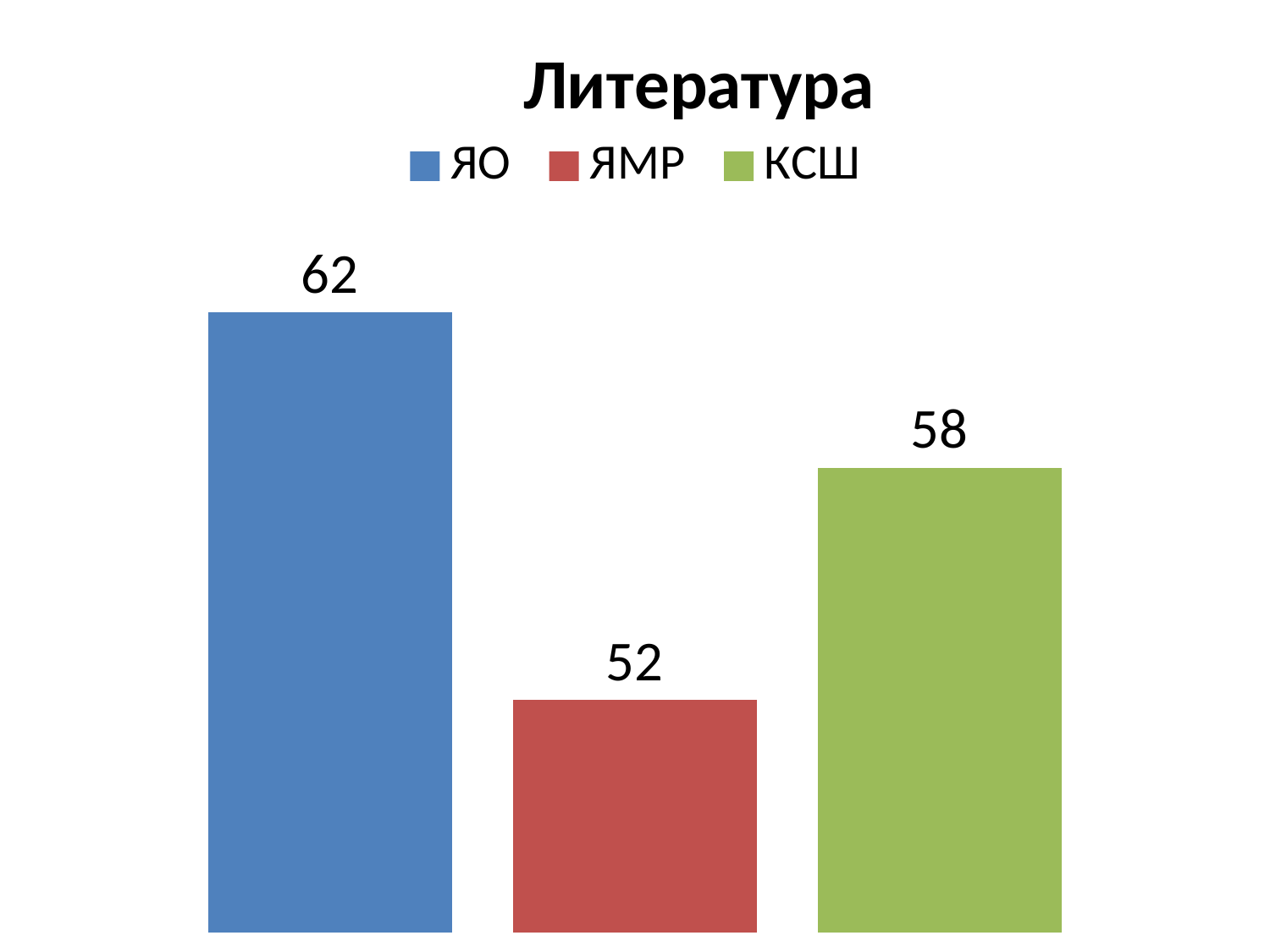
What is the value for КСШ? 58 How many bars are shown in the chart? 3 Which is larger, the value for ЯМР or the value for КСШ? КСШ What is the difference between the values for КСШ and ЯМР? 6 What is the value for ЯО? 62 What is the difference between the values for ЯО and ЯМР? 10 What kind of chart is shown on the slide? bar chart Which category has the lowest value? ЯМР What is the title of the chart? Литература Which category has the highest value? ЯО How many entries does the legend list? 3 What is the value for ЯМР? 52